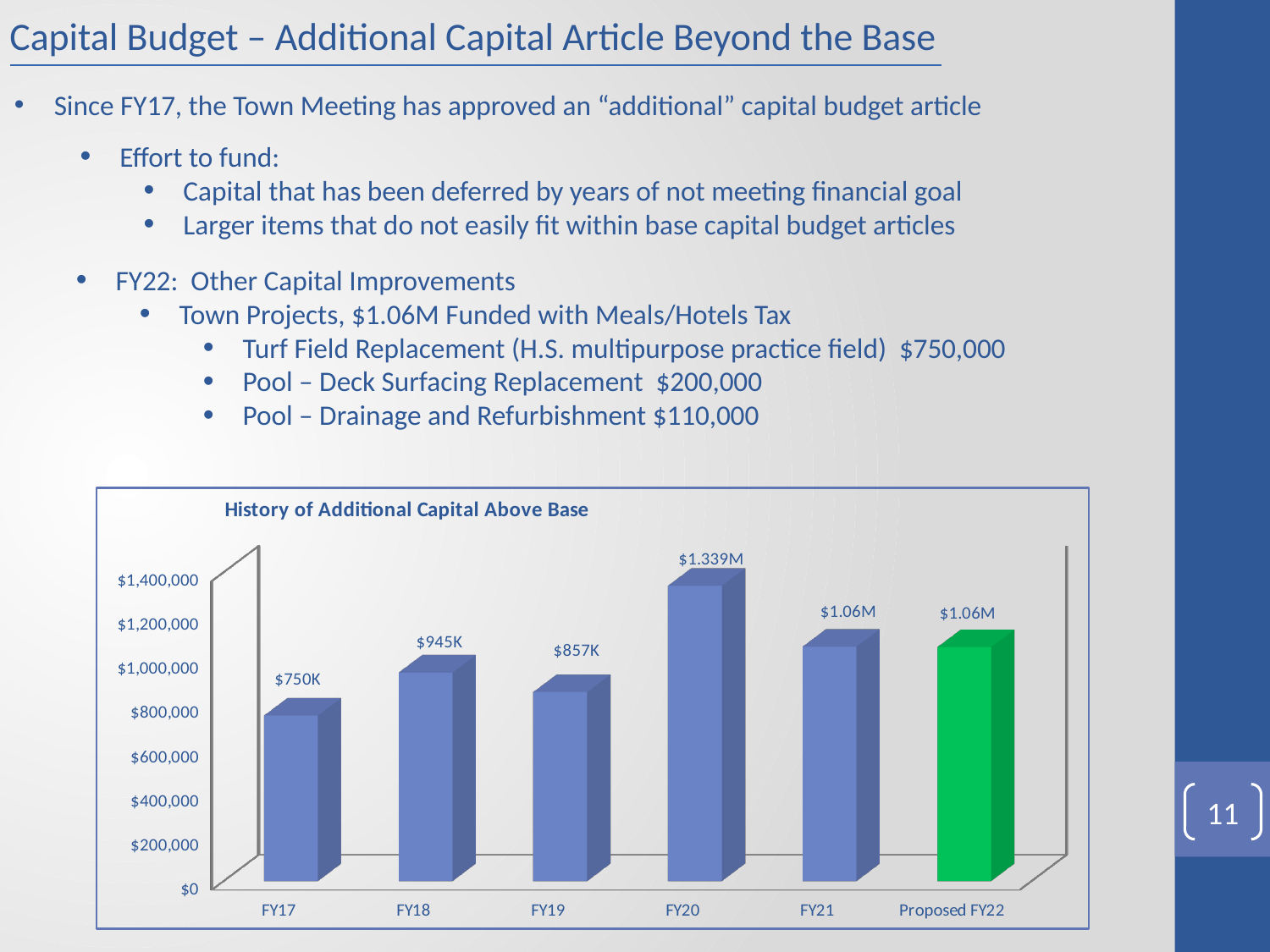
How many fiscal years are shown in the History of Additional Capital Above Base chart? 6 What is the value for FY20 in the History of Additional Capital Above Base chart? $1.339M Which fiscal year has the lowest value in the History of Additional Capital Above Base chart? FY17 What is the difference between the FY18 and FY19 values in the History of Additional Capital Above Base chart? $88K What kind of chart is the History of Additional Capital Above Base chart? Bar chart Which fiscal year has the highest value in the History of Additional Capital Above Base chart? FY20 Which is larger in the History of Additional Capital Above Base chart, the value for FY18 or FY19? FY18 Is the value for FY20 in the History of Additional Capital Above Base chart greater or less than $1,200,000? greater Which bar in the History of Additional Capital Above Base chart is coloured green? Proposed FY22 What is the value for FY17 in the History of Additional Capital Above Base chart? $750K What is the difference between the FY18 and FY17 values in the History of Additional Capital Above Base chart? $195K What is the value for Proposed FY22 in the History of Additional Capital Above Base chart? $1.06M